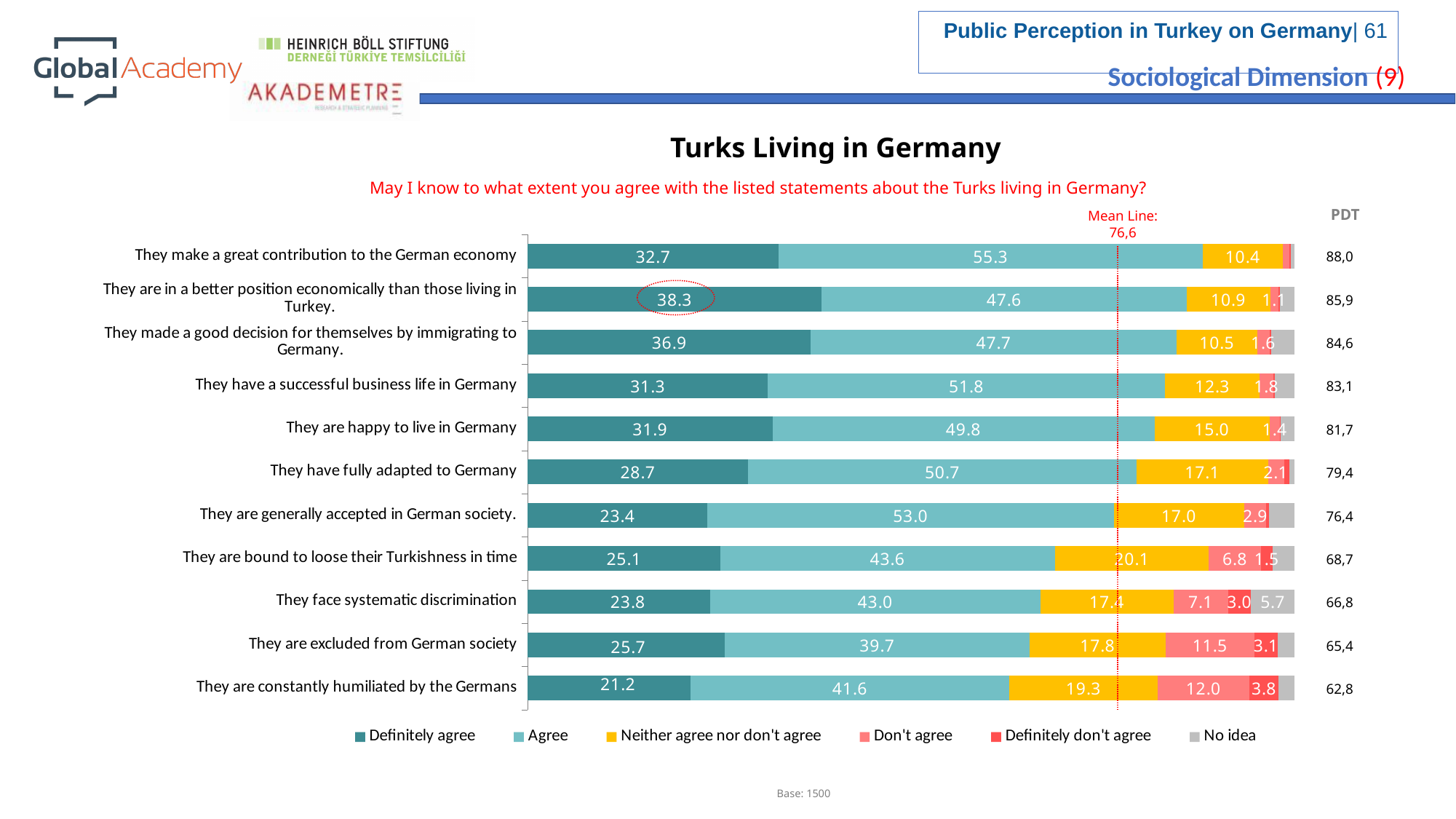
What is the difference between the "Agree" values for "They make a great contribution to the German economy" and "They are constantly humiliated by the Germans"? 13.7 What kind of chart is shown on the slide? Stacked bar chart How many series does the legend list? 6 How many statements are shown in the chart? 11 What is the "Don't agree" value for "They are constantly humiliated by the Germans"? 12.0 Which has the larger "Don't agree" value: "They are excluded from German society" or "They face systematic discrimination"? They are excluded from German society What is the "Definitely agree" value for "They make a great contribution to the German economy"? 32.7 What is the "Neither agree nor don't agree" value for "They are bound to loose their Turkishness in time"? 20.1 Which statement has the highest "Agree" value? They make a great contribution to the German economy Which statement has the lowest "Definitely agree" value? They are constantly humiliated by the Germans Which statement has the highest "Definitely agree" value? They are in a better position economically than those living in Turkey. What is the "Agree" value for "They are happy to live in Germany"? 49.8